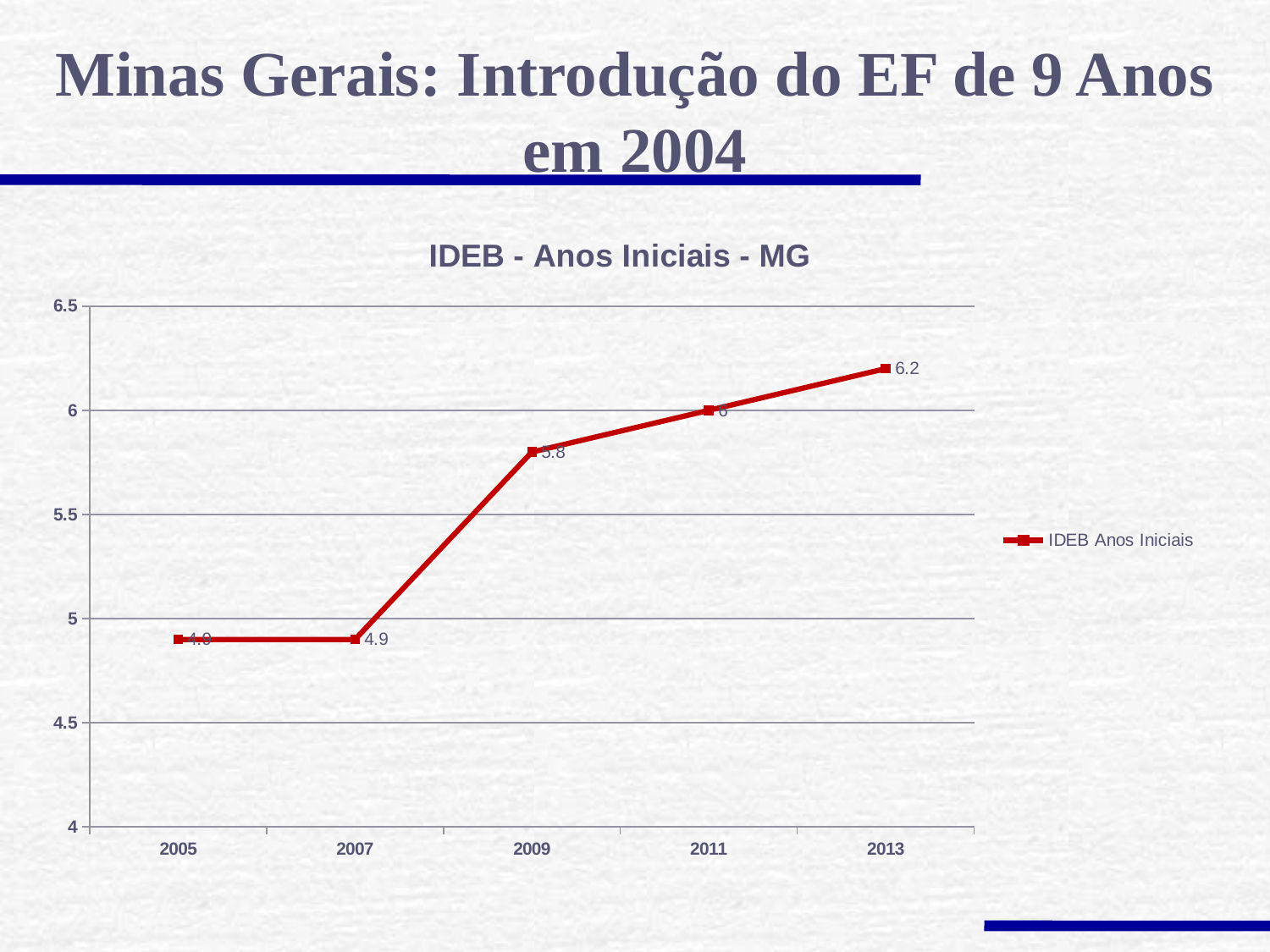
How many years are plotted on the x axis? 5 What kind of chart is shown on the slide? line chart Which year has the highest IDEB Anos Iniciais value? 2013 Which year has the larger IDEB value, 2009 or 2011? 2011 What is the IDEB Anos Iniciais value for 2007? 4.9 Is the IDEB value for 2005 greater or less than 5? less What is the difference between the IDEB values for 2013 and 2009? 0.4 What is the IDEB Anos Iniciais value for 2009? 5.8 What is the IDEB Anos Iniciais value for 2011? 6 Does the IDEB Anos Iniciais value rise or fall from 2007 to 2013? rise What is the difference between the IDEB values for 2011 and 2007? 1.1 What is the IDEB Anos Iniciais value for 2013? 6.2